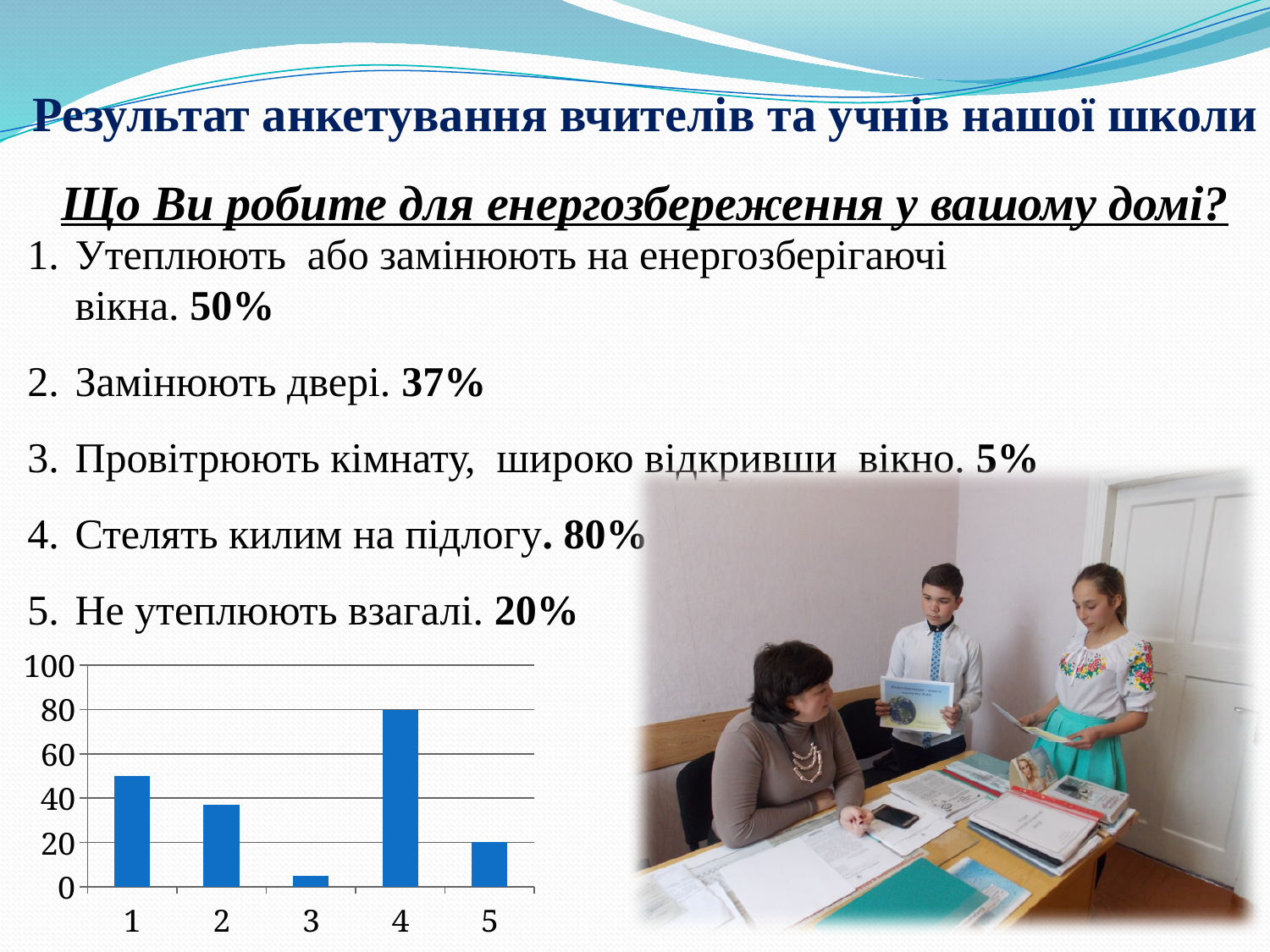
Which category has the lowest bar in the chart? 3 Which category has the highest bar in the chart? 4 Is the value for category 3 greater or less than 20? less What is the value for category 4 in the chart? 80 Is the value for category 2 greater or less than 40? less What is the difference between the values for category 4 and category 5? 60 How many categories are shown on the x axis of the chart? 5 What type of chart is shown on the slide? bar chart What is the value for category 5 in the chart? 20 Which is larger in the chart, the value for category 1 or the value for category 2? category 1 Is the value for category 1 greater or less than 40? greater What is the highest value shown on the y axis of the chart? 100